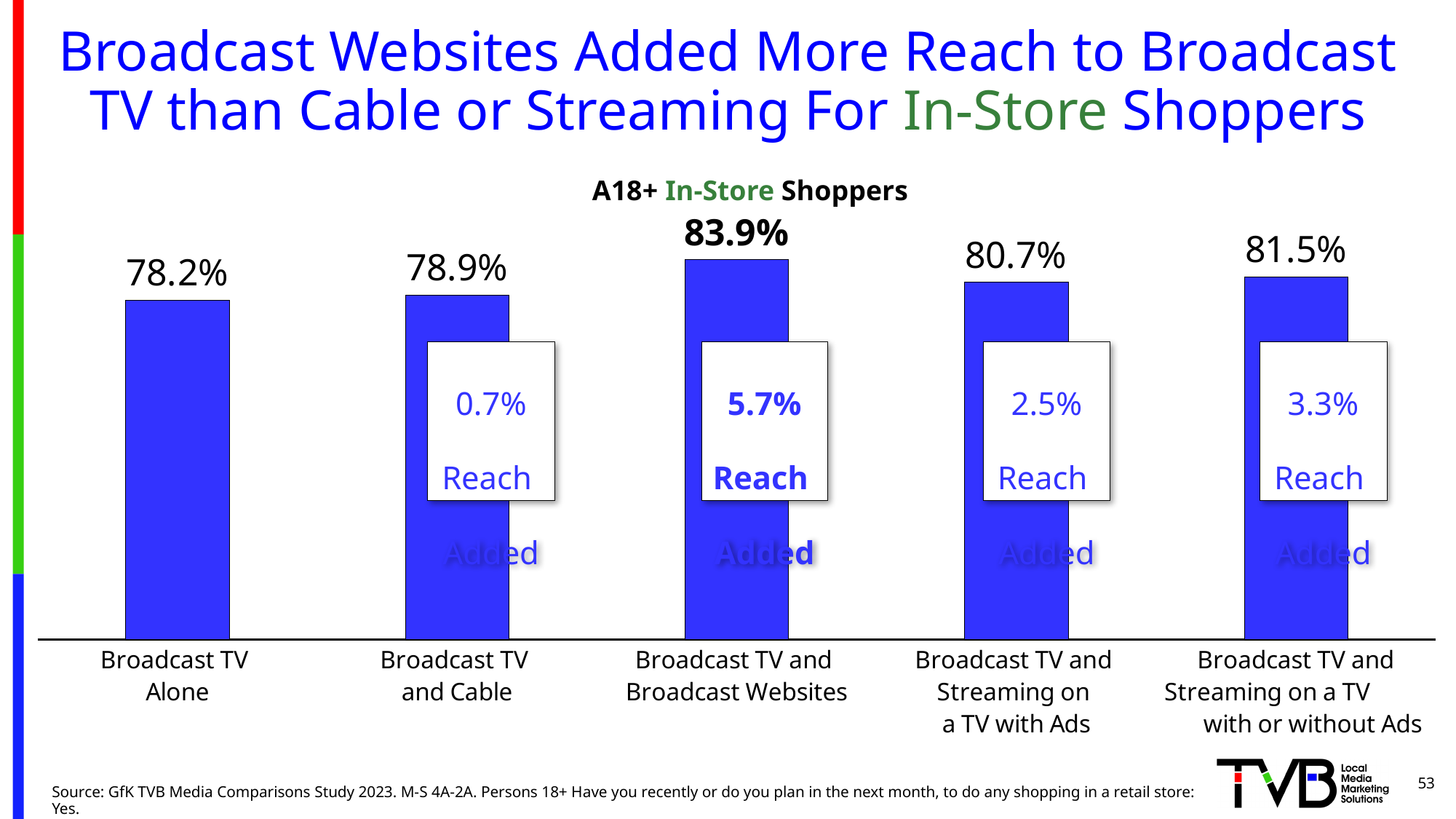
What is the reach value for Broadcast TV and Broadcast Websites? 83.9% What is the reach value for Broadcast TV and Streaming on a TV with or without Ads? 81.5% What is the reach value for Broadcast TV and Streaming on a TV with Ads? 80.7% Which category has the highest reach? Broadcast TV and Broadcast Websites What is the difference in reach between Broadcast TV and Cable and Broadcast TV Alone? 0.7% How many categories are shown in the chart? 5 What is the reach value for Broadcast TV Alone? 78.2% Which category has the lowest reach? Broadcast TV Alone Which has a higher reach: Broadcast TV and Cable or Broadcast TV and Streaming on a TV with Ads? Broadcast TV and Streaming on a TV with Ads What is the difference in reach between Broadcast TV and Broadcast Websites and Broadcast TV Alone? 5.7% What kind of chart is shown on the slide? Bar chart What is the title of the chart? A18+ In-Store Shoppers